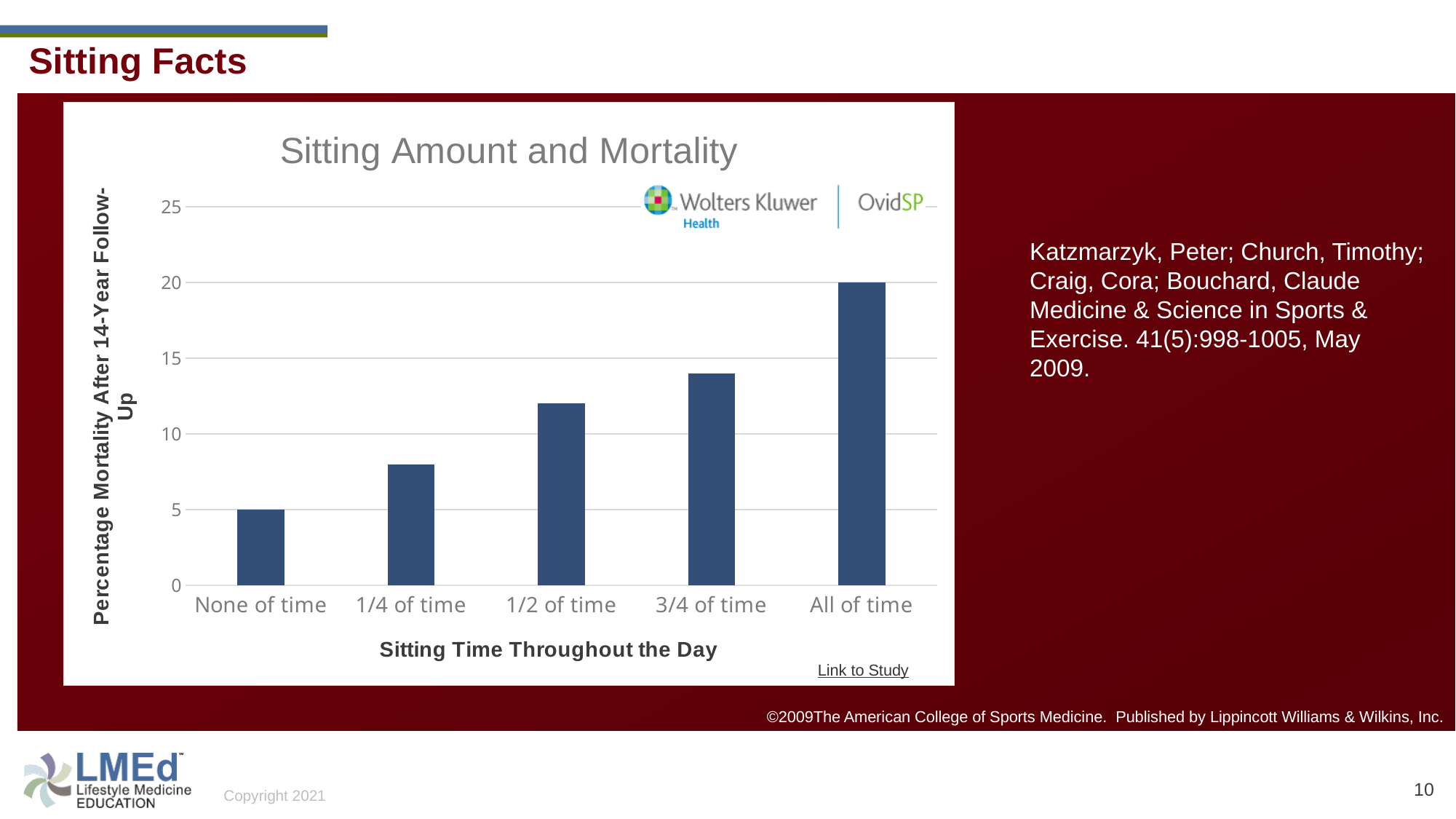
Which has a higher mortality percentage, "3/4 of time" or "1/2 of time"? 3/4 of time Is the value for "1/2 of time" greater or less than 10? greater Do the mortality values rise or fall as sitting time increases along the x axis? Rise What kind of chart is used to show Sitting Amount and Mortality? Bar chart Which sitting time category has the lowest mortality percentage? None of time Which sitting time category has the highest mortality percentage? All of time Is the value for "1/4 of time" greater or less than 10? less What is the percentage mortality value for "None of time" in the Sitting Amount and Mortality chart? 5 What is the difference between the mortality values for "All of time" and "None of time"? 15 How many sitting time categories are shown on the x axis? 5 Is the value for "3/4 of time" greater or less than 15? less What is the percentage mortality value for "All of time" in the Sitting Amount and Mortality chart? 20